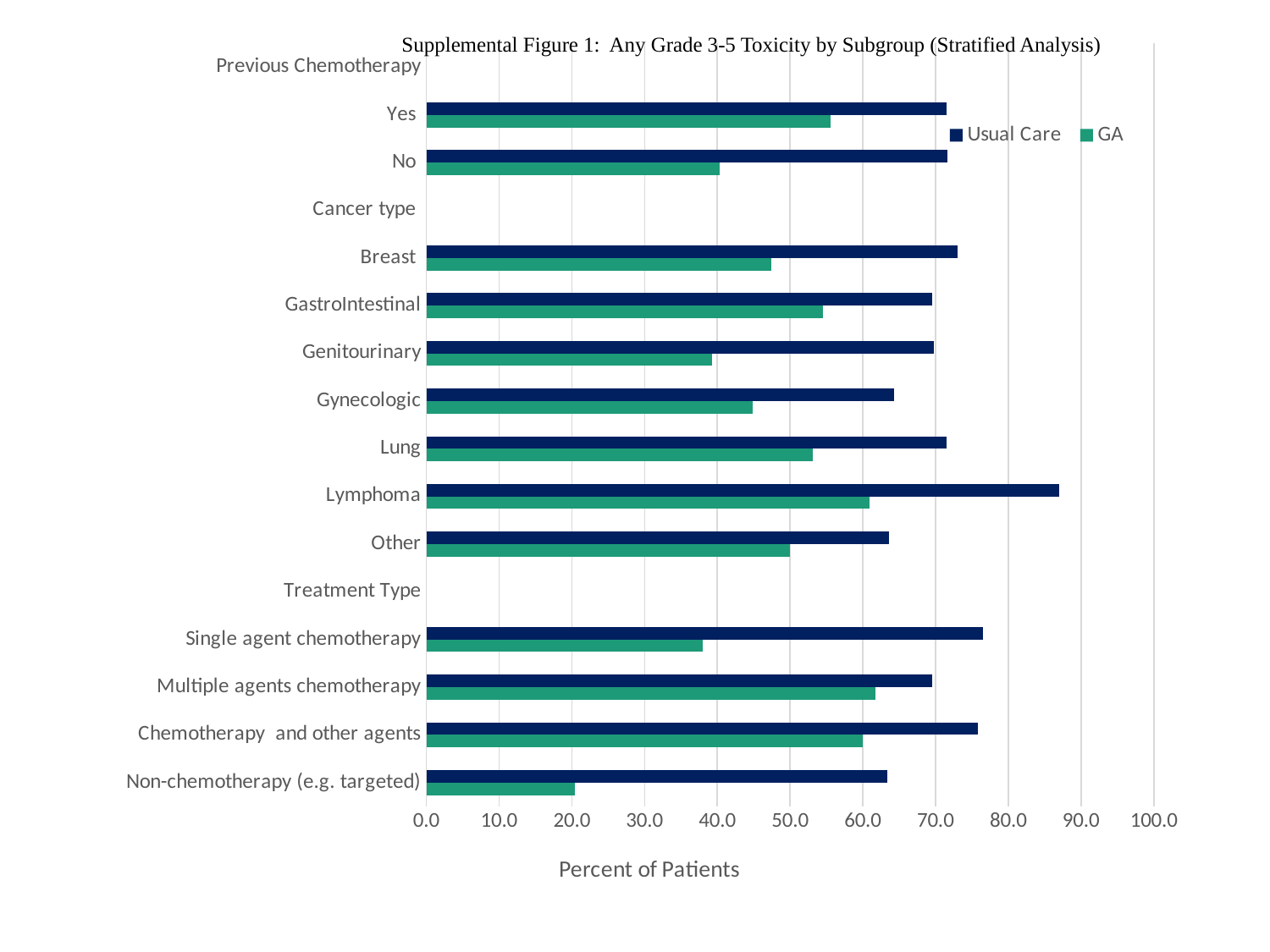
Is the GA value for Genitourinary greater or less than 50.0? less What kind of chart is shown on the slide? Bar chart Is the Usual Care value for Breast greater or less than 70.0? greater For Single agent chemotherapy, which is larger: the Usual Care value or the GA value? Usual Care Is the Usual Care value for Lymphoma greater or less than 80.0? greater What is the title of the horizontal axis? Percent of Patients Which has the larger GA value: Yes (Previous Chemotherapy) or Non-chemotherapy (e.g. targeted)? Yes How many series does the legend list? 2 Which subgroup has the lowest GA value? Non-chemotherapy (e.g. targeted) Which subgroup has the highest Usual Care value? Lymphoma What are the two series named in the legend? Usual Care and GA